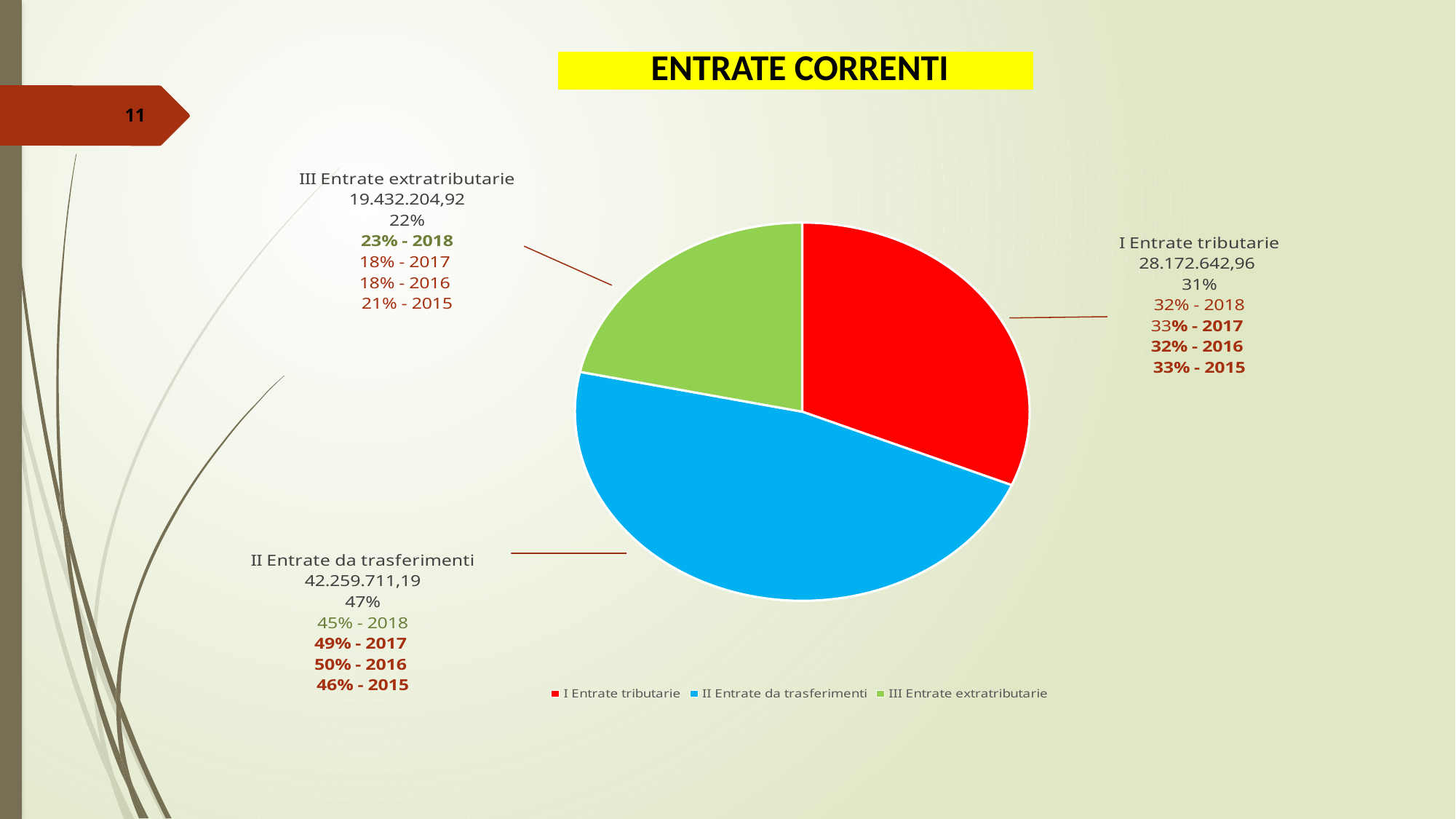
What is the value for I Entrate tributarie? 28.172.642,96 How many categories does the pie chart have? 3 What is the value for III Entrate extratributarie? 19.432.204,92 What type of chart is shown on the slide? pie chart What share of the pie does I Entrate tributarie represent? 31% Which is larger, I Entrate tributarie or III Entrate extratributarie? I Entrate tributarie What share of the pie does II Entrate da trasferimenti represent? 47% Which category has the smallest slice of the pie? III Entrate extratributarie What colour is the slice for II Entrate da trasferimenti? blue What share of the pie does III Entrate extratributarie represent? 22% Which category has the largest slice of the pie? II Entrate da trasferimenti What is the value for II Entrate da trasferimenti? 42.259.711,19